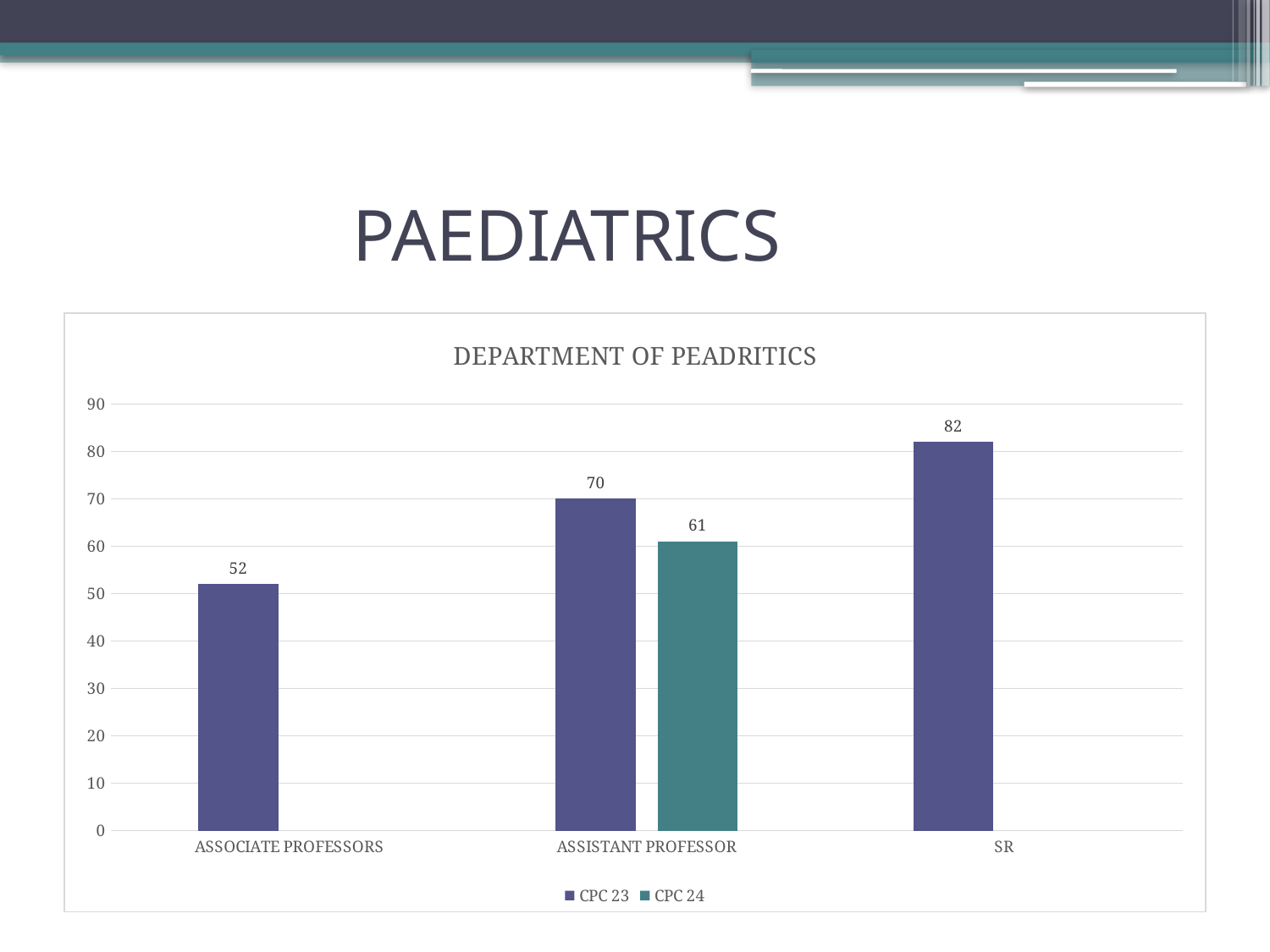
How many series does the legend list? 2 What kind of chart is shown on the slide? bar chart What is the difference between the CPC 23 values for SR and ASSOCIATE PROFESSORS? 30 How many categories are shown on the x axis? 3 Which is larger: the CPC 23 value for ASSISTANT PROFESSOR or the CPC 24 value for ASSISTANT PROFESSOR? CPC 23 Which category has the highest CPC 23 value? SR Is the CPC 23 value for SR greater or less than 80? greater Which category has the lowest CPC 23 value? ASSOCIATE PROFESSORS What is the CPC 23 value for SR? 82 What is the CPC 24 value for ASSISTANT PROFESSOR? 61 What is the CPC 23 value for ASSOCIATE PROFESSORS? 52 What is the difference between the CPC 23 and CPC 24 values for ASSISTANT PROFESSOR? 9